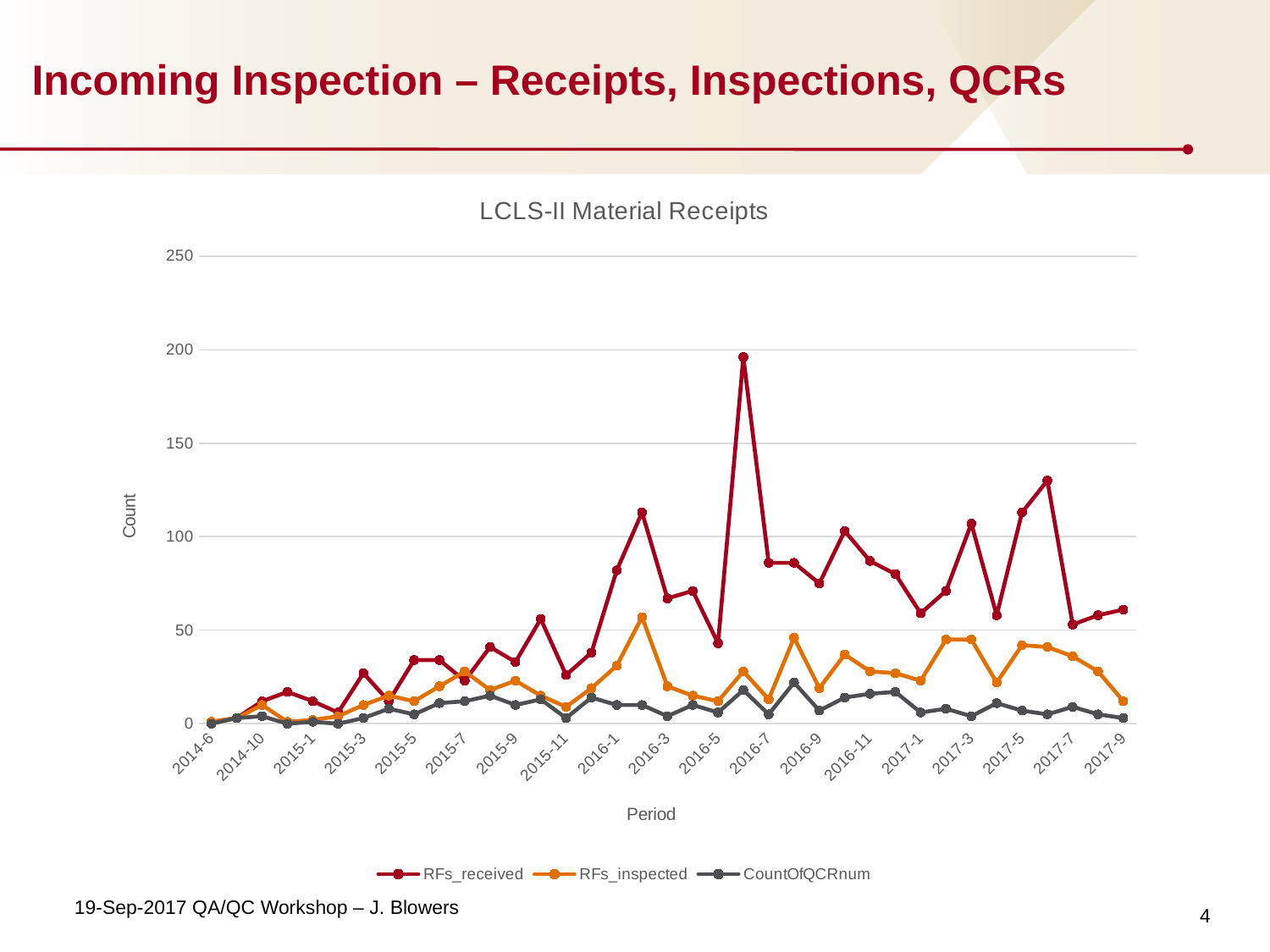
What kind of chart is shown on the slide? line chart Which series stays lowest across the chart? CountOfQCRnum What is the label of the y axis? Count Does the RFs_received series generally rise or fall from 2014-6 to 2016-1? rise Which series reaches the highest value on the chart? RFs_received Is the value for RFs_received at 2017-3 greater or less than 100? greater How many series does the legend list? 3 At 2016-7, which is larger: RFs_received or RFs_inspected? RFs_received What is the title of the chart? LCLS-II Material Receipts Is the value for RFs_received at 2016-7 greater or less than 100? less Is the value for RFs_inspected at 2016-3 greater or less than 50? less